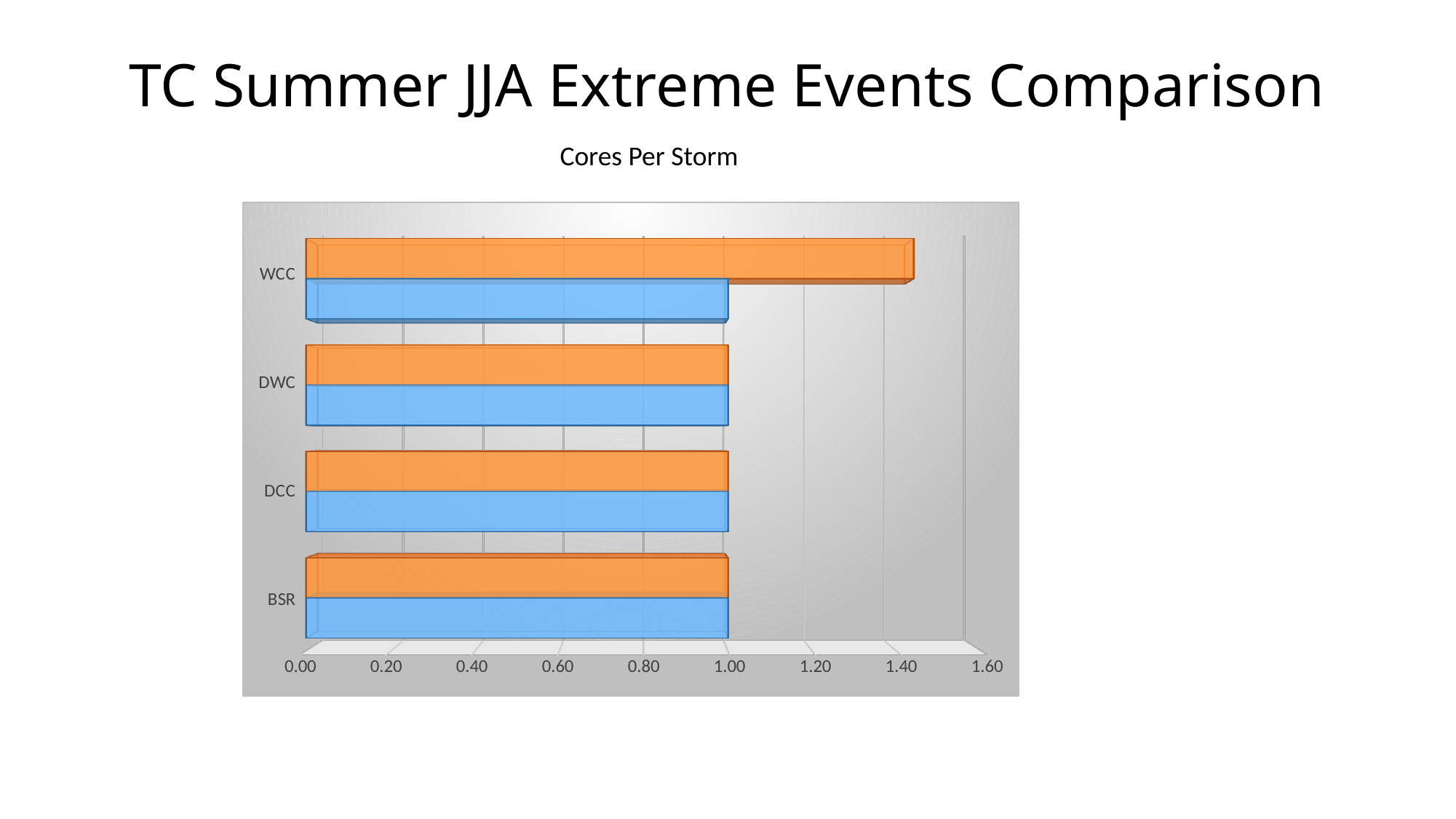
What is the value of the blue bar for DWC? 1.00 Which category has the longest orange bar? WCC Which is larger, the orange bar for WCC or the orange bar for DWC? WCC What is the value of the orange bar for DCC? 1.00 Is the value of the orange bar for WCC greater or less than 1.60? less What kind of chart is shown on the slide? bar chart Is the value of the orange bar for WCC greater or less than 1.20? greater How many categories are shown on the vertical axis of the chart? 4 What is the value of the blue bar for BSR? 1.00 How many bars are plotted for each category in the chart? 2 What is the title of the chart? Cores Per Storm What two colours are used for the bars in the chart? orange and blue